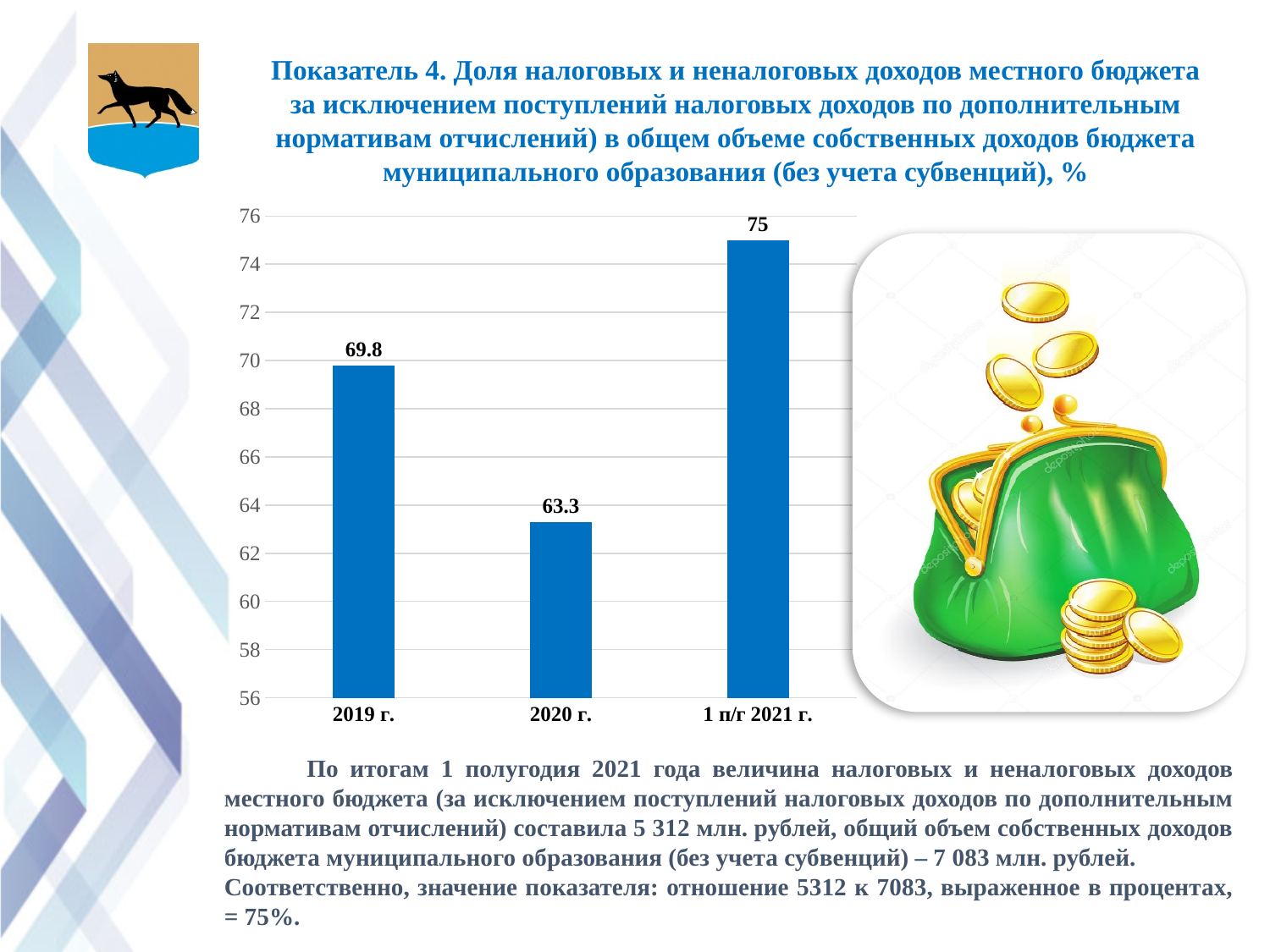
What is the difference between the values for 2019 г. and 2020 г.? 6.5 Which is larger, the value for 2019 г. or the value for 1 п/г 2021 г.? 1 п/г 2021 г. Is the value for 2020 г. greater or less than 64? less What is the value for 2020 г.? 63.3 What is the difference between the values for 1 п/г 2021 г. and 2020 г.? 11.7 What is the value for 1 п/г 2021 г.? 75 Which category has the lowest value? 2020 г. How many categories are shown on the x axis? 3 Which category has the highest value? 1 п/г 2021 г. What is the lowest value shown on the vertical axis? 56 What kind of chart is shown on the slide? bar chart What is the value for 2019 г.? 69.8